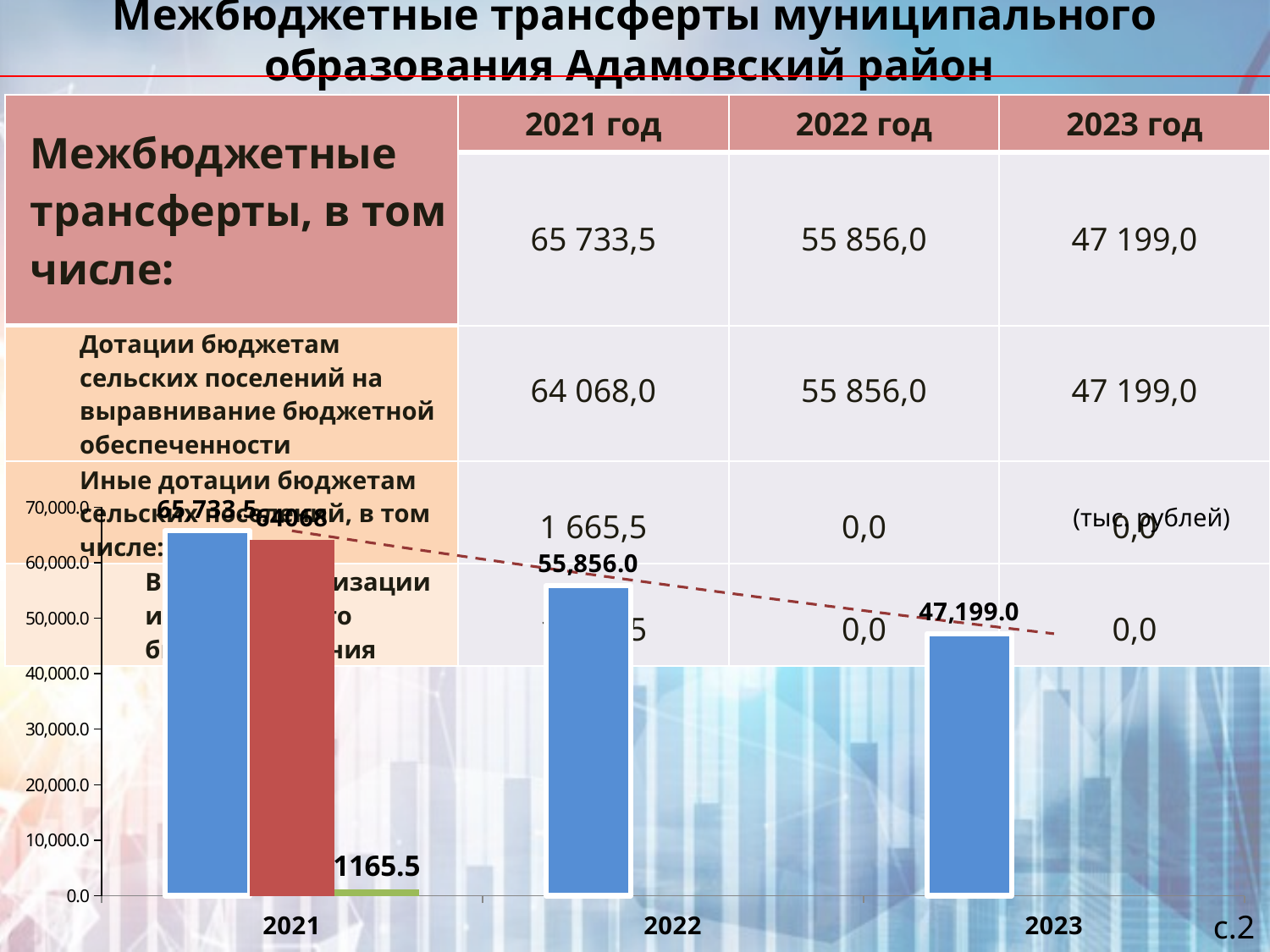
What is the difference between the 2022 bar (55,856.0) and the 2023 bar (47,199.0)? 8,657.0 What kind of chart is shown at the bottom of the slide? bar chart What is the value of the green bar for 2021 in the chart? 1165.5 Do the blue bars rise or fall from 2021 to 2023? fall How many years are shown on the x axis of the chart? 3 What is the difference between the blue 2021 bar (65,733.5) and the 2022 bar (55,856.0)? 9,877.5 How many bars are plotted for the year 2021 in the chart? 3 Is the value for 2023 greater or less than 50,000.0? less Which year has the tallest bar in the chart? 2021 What is the value of the bar for 2023 in the chart? 47,199.0 What is the value of the blue bar for 2021 in the chart? 65,733.5 What is the value of the bar for 2022 in the chart? 55,856.0